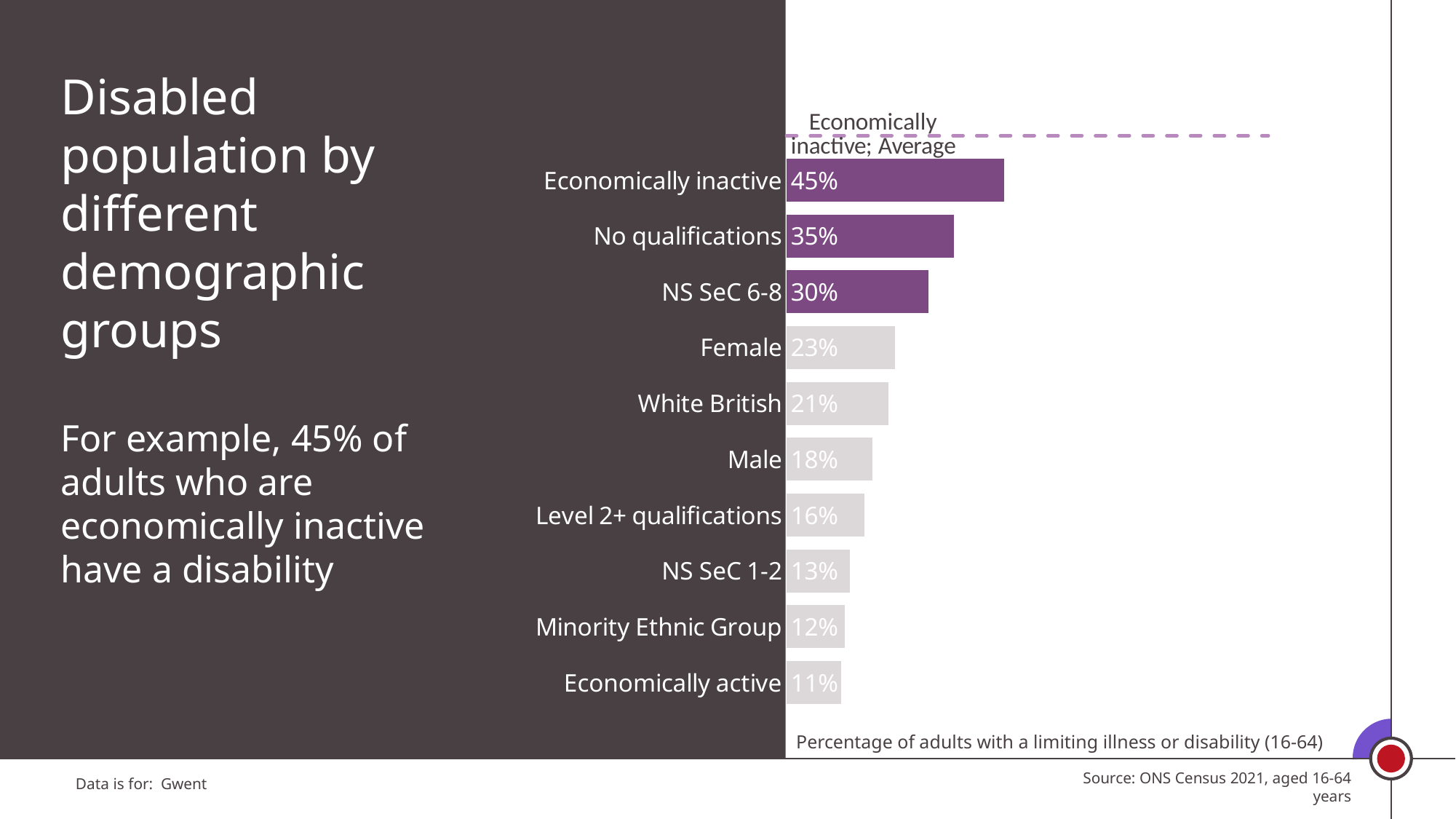
What type of chart is shown on the slide? Bar chart How many bars are coloured purple rather than grey? 3 How many categories are shown in the bar chart? 10 What is the value shown for Minority Ethnic Group? 12% What percentage of economically inactive adults have a limiting illness or disability? 45% What is the value shown for the Female category? 23% What is the difference in percentage points between No qualifications and Level 2+ qualifications? 19 What is the value shown for NS SeC 1-2? 13% Which has a higher value, White British or Minority Ethnic Group? White British What is the difference in percentage points between Female and Male? 5 Which category has the highest percentage of adults with a limiting illness or disability? Economically inactive Which category has the lowest percentage of adults with a limiting illness or disability? Economically active